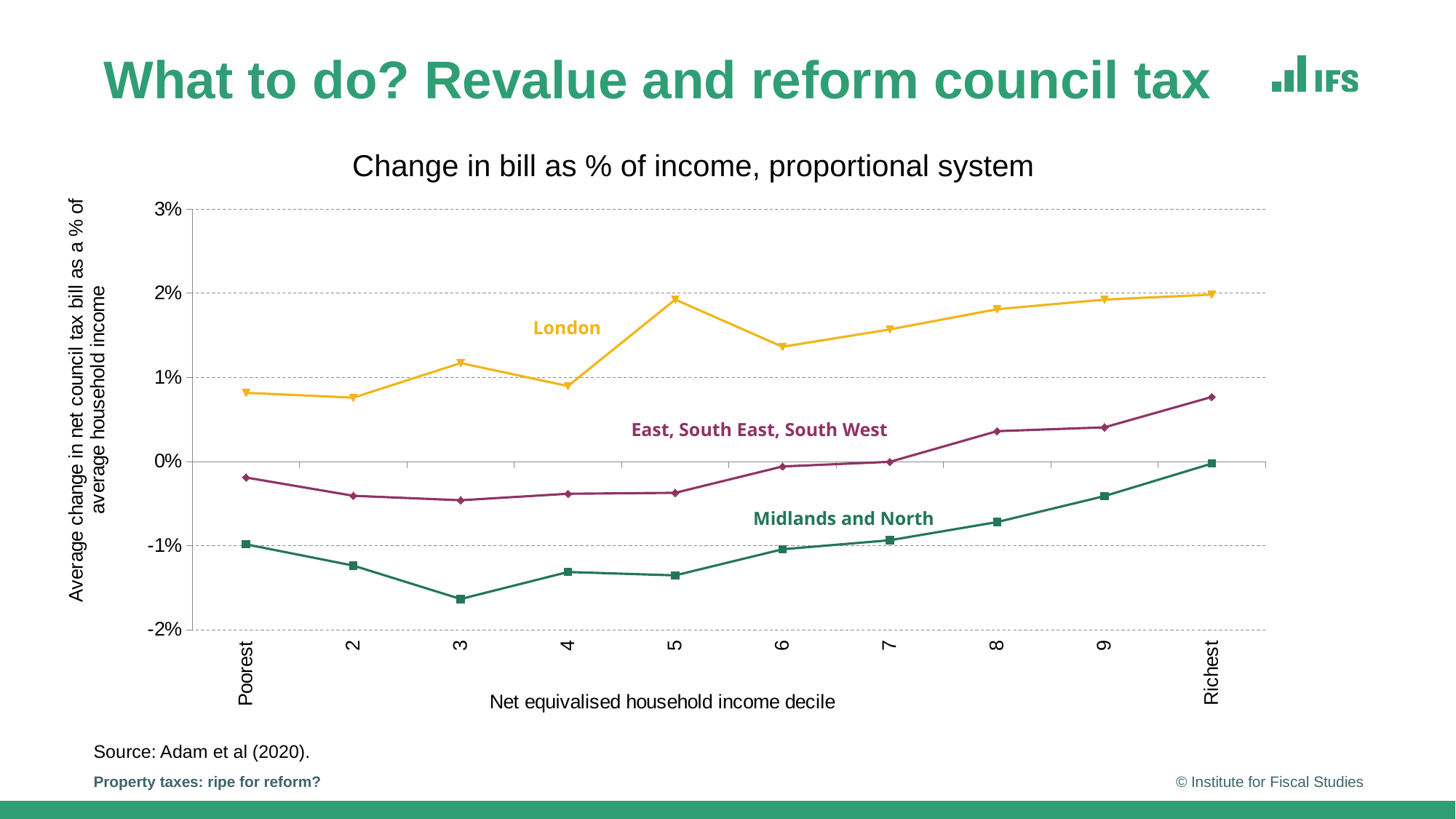
How many income deciles are plotted along the x axis? 10 At decile 5, which series has the larger value: London or Midlands and North? London Is the value for London at decile 5 greater or less than 1%? greater Is the value for London at the Poorest decile greater or less than 1%? less For which income decile is the Midlands and North value highest? Richest Does the Midlands and North line rise or fall from decile 3 to the Richest decile? rise What is the title of the chart? Change in bill as % of income, proportional system What kind of chart is shown on the slide? line chart Is the value for East, South East, South West at the Richest decile greater or less than 0%? greater How many series (regions) are plotted on the chart? 3 For which income decile is the Midlands and North value lowest? 3